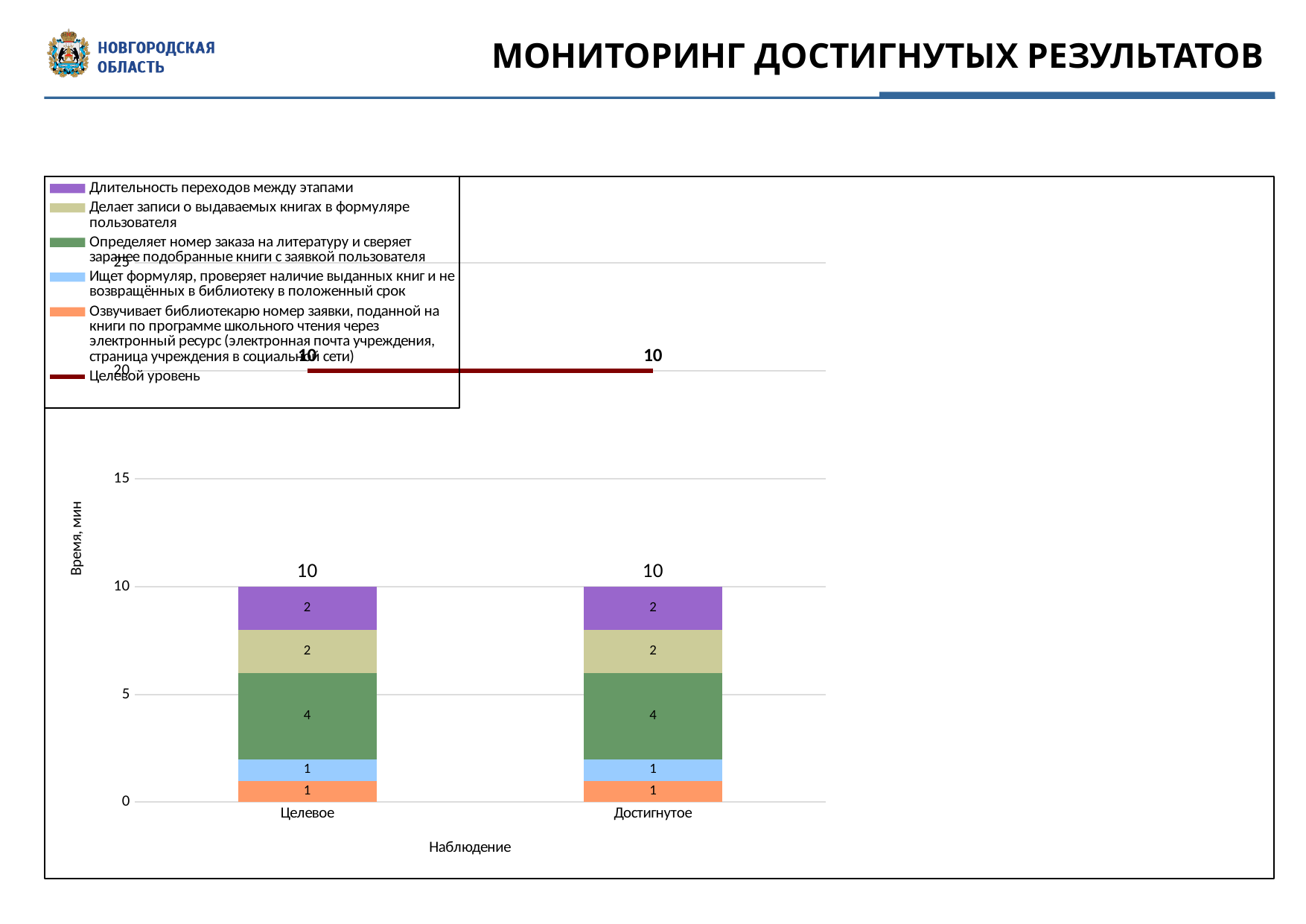
How many categories are shown on the x axis of the chart? 2 What is the value of the 'Озвучивает библиотекарю номер заявки...' segment for Целевое? 1 What is the label of the y axis of the chart? Время, мин What is the label of the x axis of the chart? Наблюдение What is the difference between the 'Определяет номер заказа...' segment and the 'Делает записи о выдаваемых книгах...' segment for Целевое? 2 What is the value of the 'Ищет формуляр, проверяет наличие выданных книг...' segment for Достигнутое? 1 How many entries does the chart legend list? 6 What is the total of the stacked bar for Достигнутое? 10 What is the value of the 'Определяет номер заказа на литературу и сверяет заранее подобранные книги с заявкой пользователя' segment for Достигнутое? 4 What kind of chart is shown on the slide? combination stacked bar and line chart What is the value of the 'Длительность переходов между этапами' segment for Целевое? 2 What is the total of the stacked bar for Целевое? 10